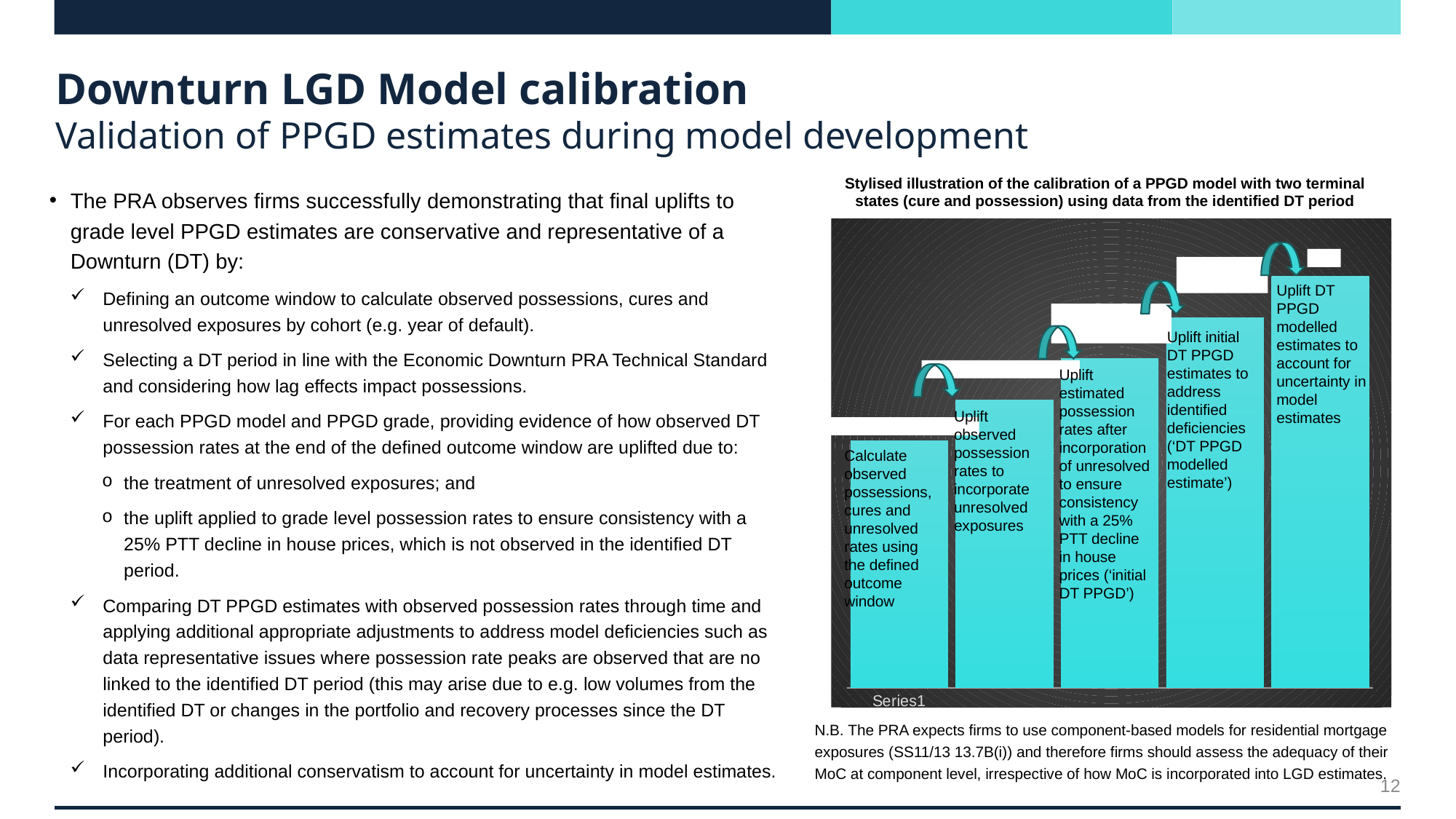
Which bar is taller: the 'Calculate observed possessions' bar or the 'Uplift observed possession rates to incorporate unresolved exposures' bar? Uplift observed possession rates to incorporate unresolved exposures Do the bar heights rise or fall from left to right across the chart? Rise Which bar is taller: the 'initial DT PPGD' bar or the 'DT PPGD modelled estimate' bar? DT PPGD modelled estimate What is the label of the fourth bar from the left in the chart? Uplift initial DT PPGD estimates to address identified deficiencies ('DT PPGD modelled estimate') What is the title of the chart on the slide? Stylised illustration of the calibration of a PPGD model with two terminal states (cure and possession) using data from the identified DT period How many bars does the stylised illustration chart contain? 5 What is the label of the third bar from the left in the chart? Uplift estimated possession rates after incorporation of unresolved to ensure consistency with a 25% PTT decline in house prices ('initial DT PPGD') Which bar in the chart is the shortest? Calculate observed possessions, cures and unresolved rates using the defined outcome window What kind of chart is shown on the right of the slide? Bar chart Which bar in the chart is the tallest? Uplift DT PPGD modelled estimates to account for uncertainty in model estimates